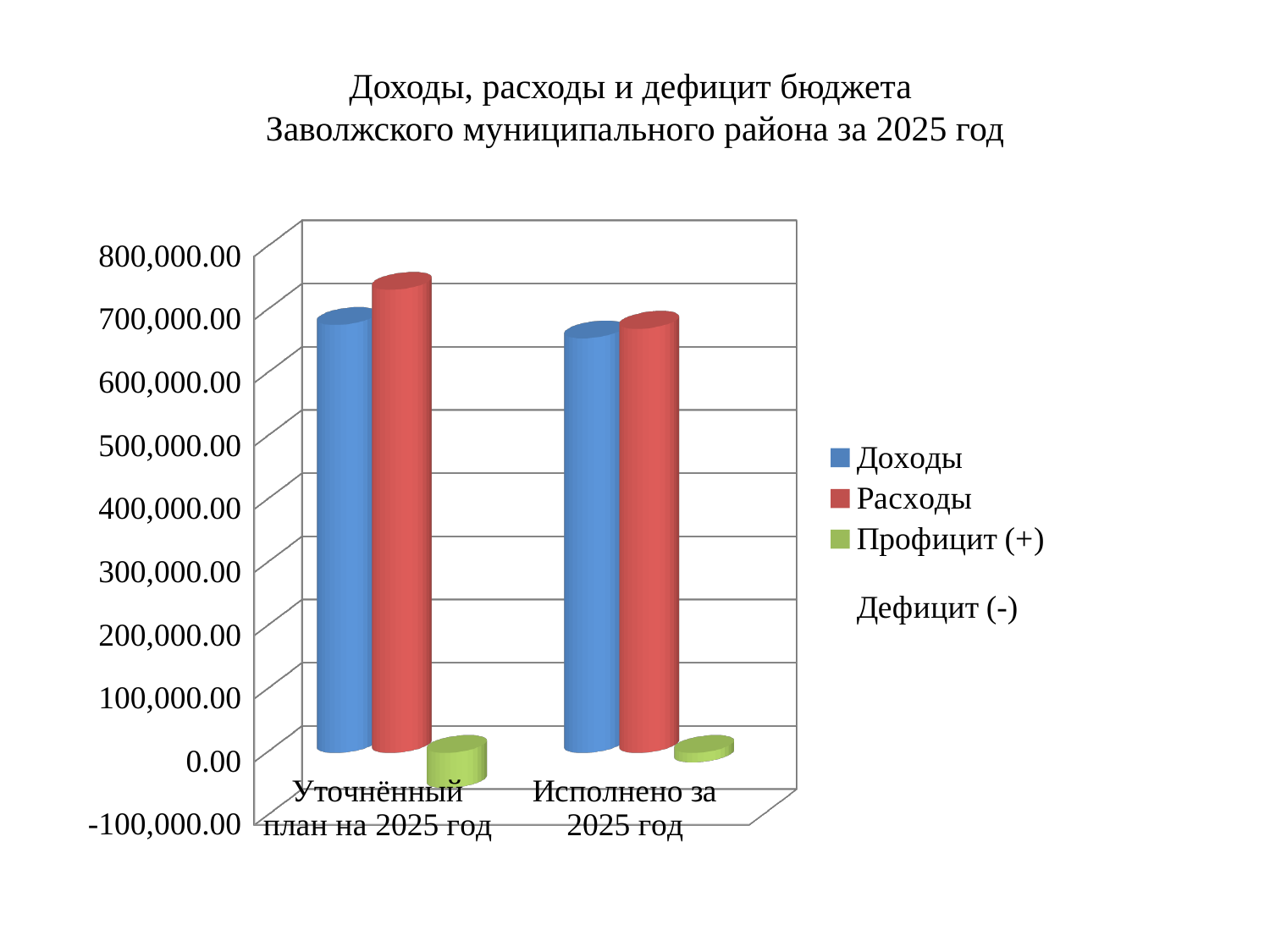
What kind of chart is shown on the slide? bar chart Which series has the lowest value in the category "Исполнено за 2025 год"? Профицит (+) Дефицит (-) Is the value of Доходы for "Уточнённый план на 2025 год" greater or less than 600,000.00? greater What is the title of the chart? Доходы, расходы и дефицит бюджета Заволжского муниципального района за 2025 год In the category "Уточнённый план на 2025 год", which is larger: Доходы or Расходы? Расходы Is the value of Расходы for "Исполнено за 2025 год" greater or less than 500,000.00? greater How many categories are shown on the x axis of the chart? 2 How many series does the chart's legend list? 3 Does the value of Доходы rise or fall from "Уточнённый план на 2025 год" to "Исполнено за 2025 год"? fall Is the value of Профицит (+) Дефицит (-) for "Уточнённый план на 2025 год" greater or less than 0.00? less Which series is shown in green in the chart? Профицит (+) Дефицит (-) Which series has the highest value in the category "Уточнённый план на 2025 год"? Расходы